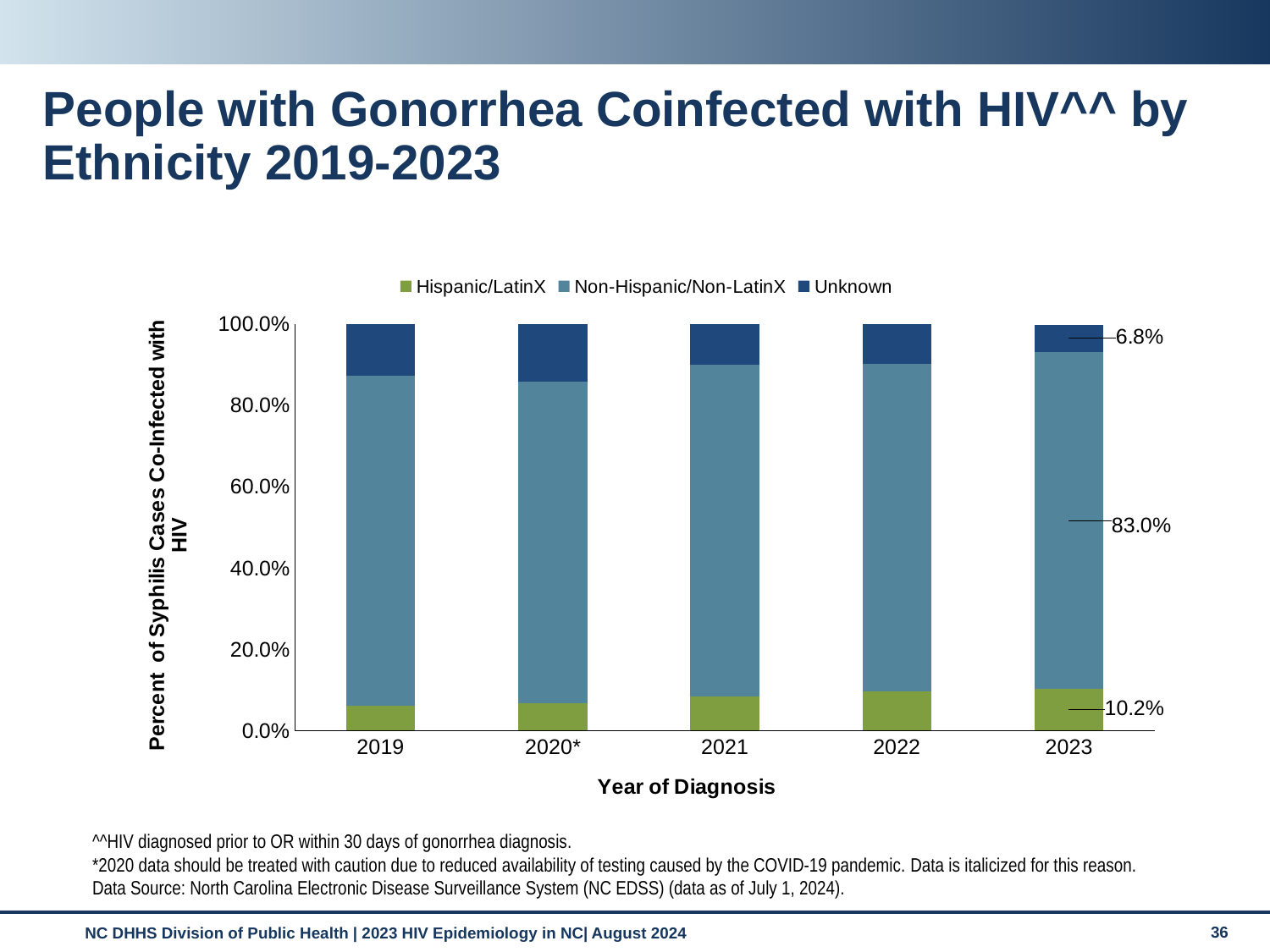
Which series has the highest value in 2023? Non-Hispanic/Non-LatinX How many series does the legend list? 3 What kind of chart is shown on the slide? Stacked bar chart Is the Hispanic/LatinX value for 2019 greater or less than 20%? less What is the total of the stacked bar for 2023? 100.0% How many years are shown on the x axis? 5 What is the Hispanic/LatinX value for 2023? 10.2% What is the Non-Hispanic/Non-LatinX value for 2023? 83.0% What is the Unknown value for 2023? 6.8% What is the title of the x axis? Year of Diagnosis What is the difference between the Non-Hispanic/Non-LatinX and Hispanic/LatinX values for 2023? 72.8% Which is larger for 2023, the Hispanic/LatinX value or the Unknown value? Hispanic/LatinX